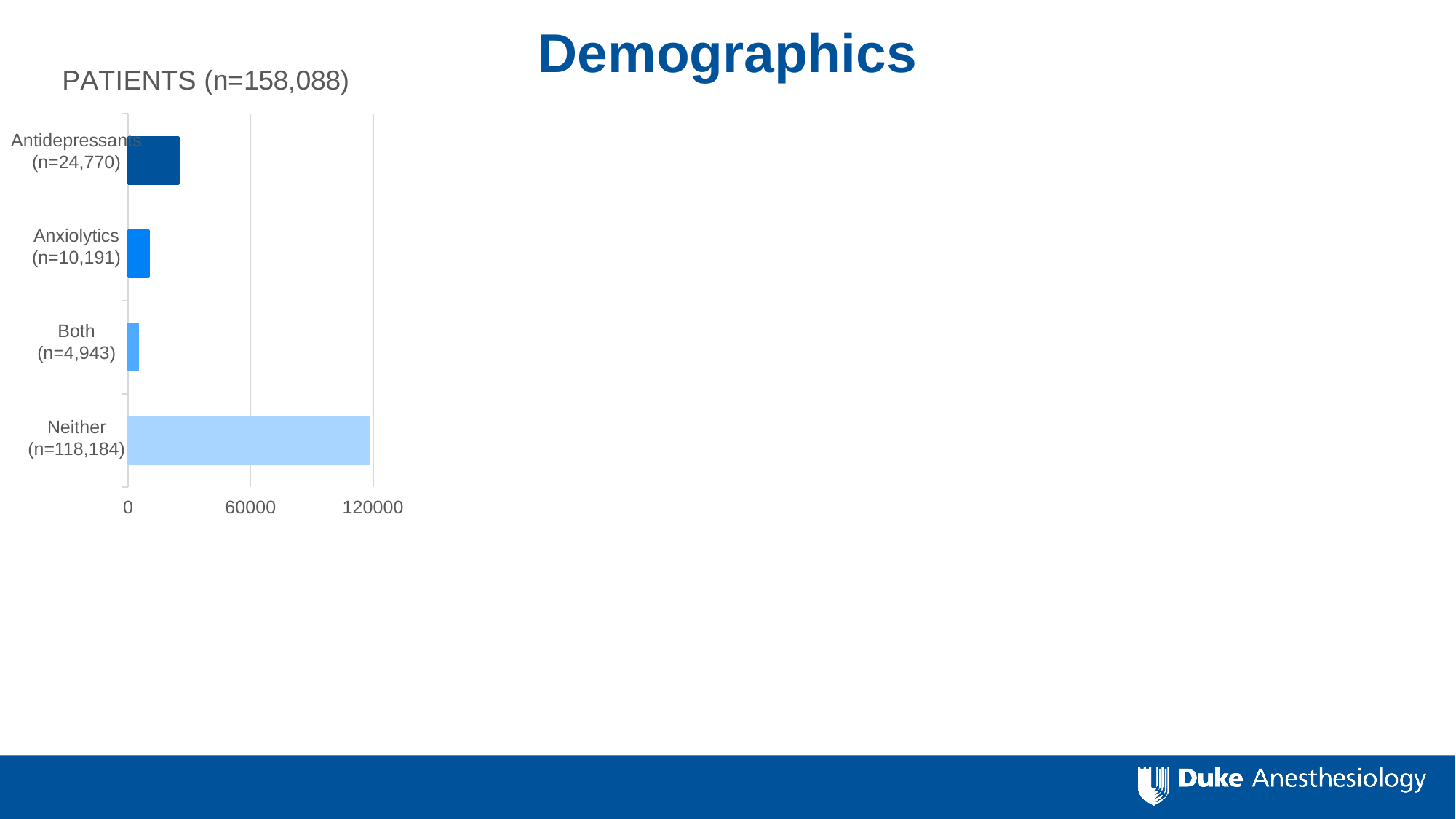
Which category has the largest number of patients? Neither What is the number of patients in the Neither category? 118,184 What is the number of patients in the Anxiolytics category? 10,191 How many more patients are in the Antidepressants category than in the Anxiolytics category? 14,579 How many categories are shown in the chart? 4 Which category has more patients, Anxiolytics or Both? Anxiolytics What is the difference in patient numbers between the Neither and Antidepressants categories? 93,414 What is the number of patients in the Both category? 4,943 What is the number of patients in the Antidepressants category? 24,770 Is the value for Neither greater or less than 60000? greater What type of chart is shown on the slide? Bar chart Which category has the smallest number of patients? Both